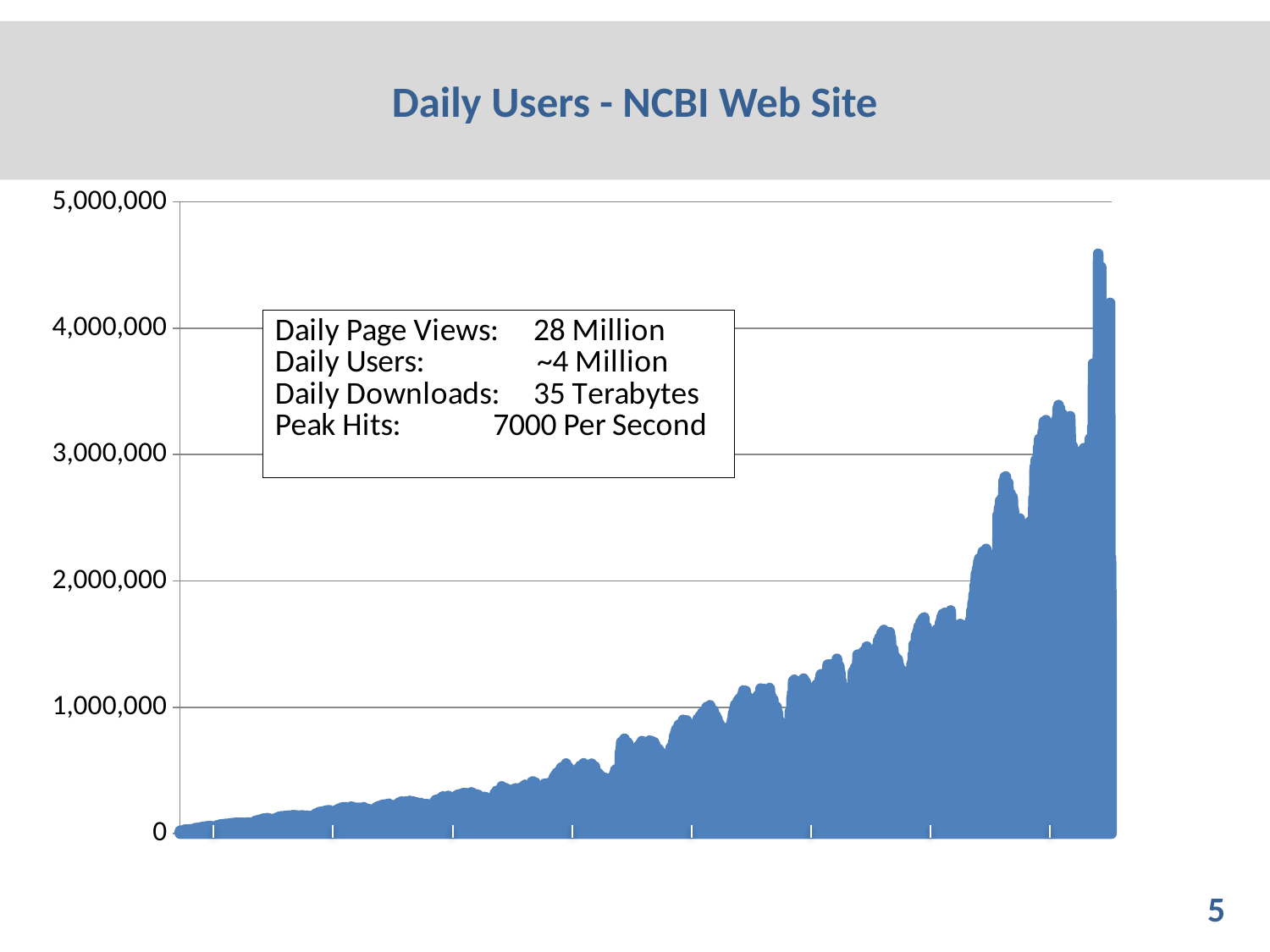
Is the highest peak of the plotted area greater or less than 4,000,000? greater Do the values generally rise or fall from left to right along the x axis? rise Is the value at the far left of the chart greater or less than 1,000,000? less What is the highest value shown on the y axis? 5,000,000 What kind of chart is shown on the slide? area chart Is the highest peak of the plotted area greater or less than 5,000,000? less What is the title of the chart? Daily Users - NCBI Web Site How many data series are plotted in the chart? 1